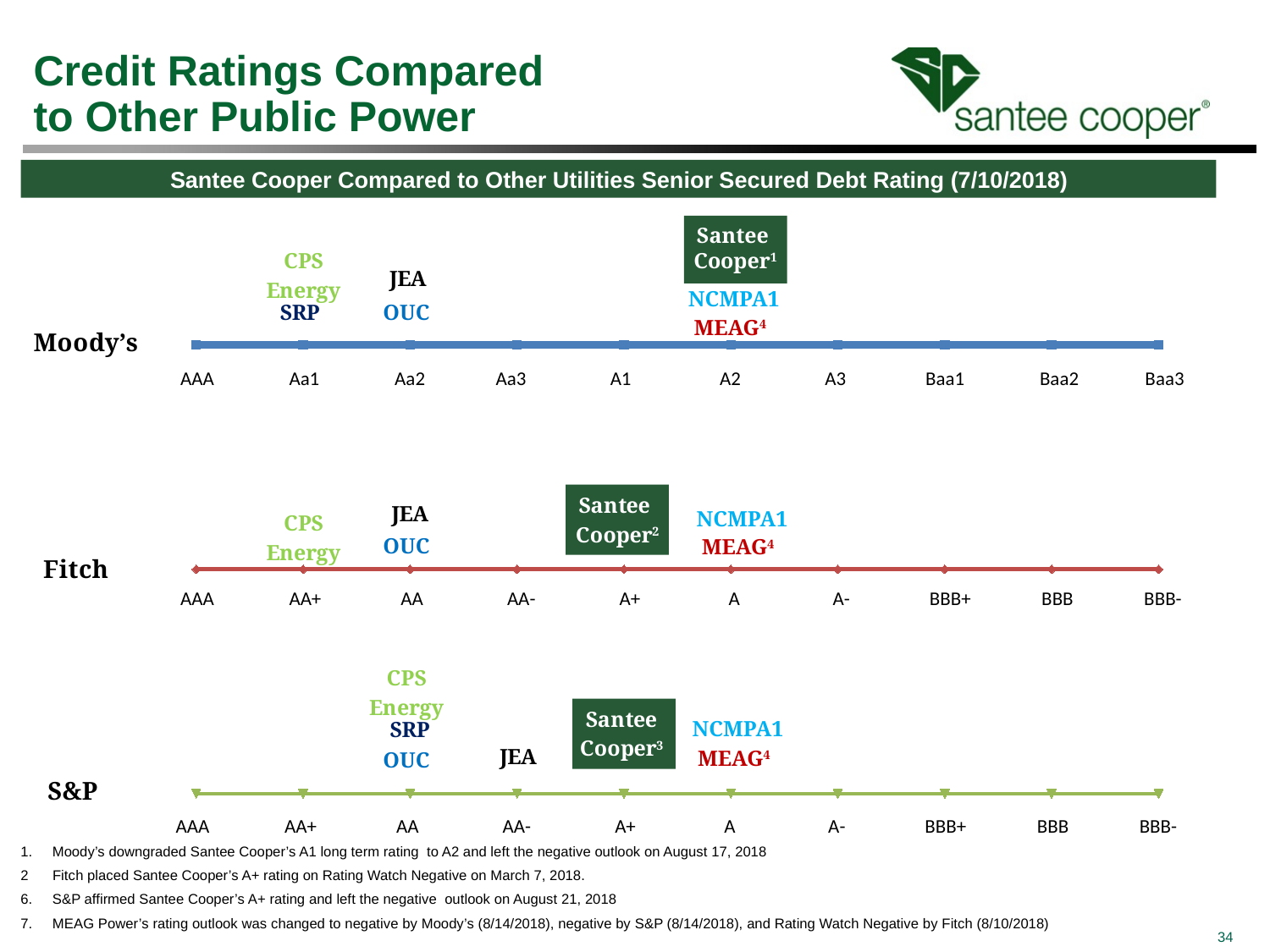
How many rating categories are marked along the Moody's scale? 10 On the Moody's scale, which utilities are positioned at the highest rating shown? CPS Energy and SRP On the Fitch scale, which utility is positioned at the highest rating shown? CPS Energy On the S&P scale, what rating is JEA positioned at? AA- On the Fitch scale, what rating is Santee Cooper positioned at? A+ On the S&P scale, is JEA rated higher or lower than Santee Cooper? higher On the Moody's scale, what rating is Santee Cooper positioned at? A2 On the S&P scale, what rating is CPS Energy positioned at? AA On the Moody's scale, what rating are JEA and OUC positioned at? Aa2 What is the title of the chart on the slide? Santee Cooper Compared to Other Utilities Senior Secured Debt Rating (7/10/2018) On the Fitch scale, what rating are NCMPA1 and MEAG positioned at? A How many rating agency scales are shown on the slide? 3